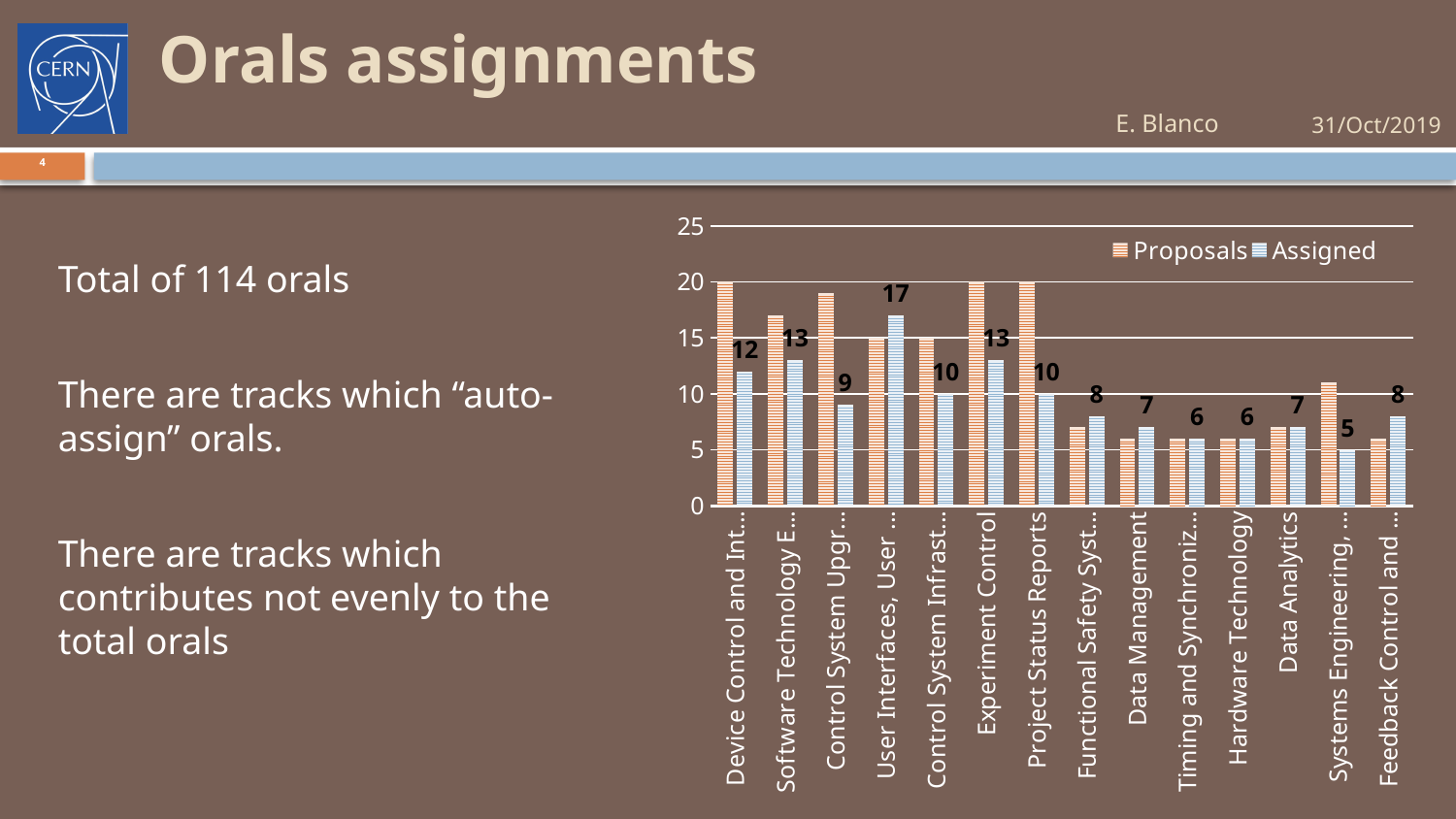
How many categories are shown on the x axis of the chart? 14 How many series does the chart's legend list? 2 What is the Assigned value for Experiment Control? 13 Is the Proposals value for Data Management greater or less than 10? less What kind of chart is shown on the slide? bar chart Which category has the highest Assigned value? User Interfaces, User ... Is the Proposals value for Experiment Control greater or less than 15? greater Which category has the lowest Assigned value? Systems Engineering, ... What is the Assigned value for Hardware Technology? 6 What is the Assigned value for Project Status Reports? 10 Which has a larger Assigned value, Hardware Technology or Data Analytics? Data Analytics What is the difference between the Assigned values for Experiment Control and Project Status Reports? 3